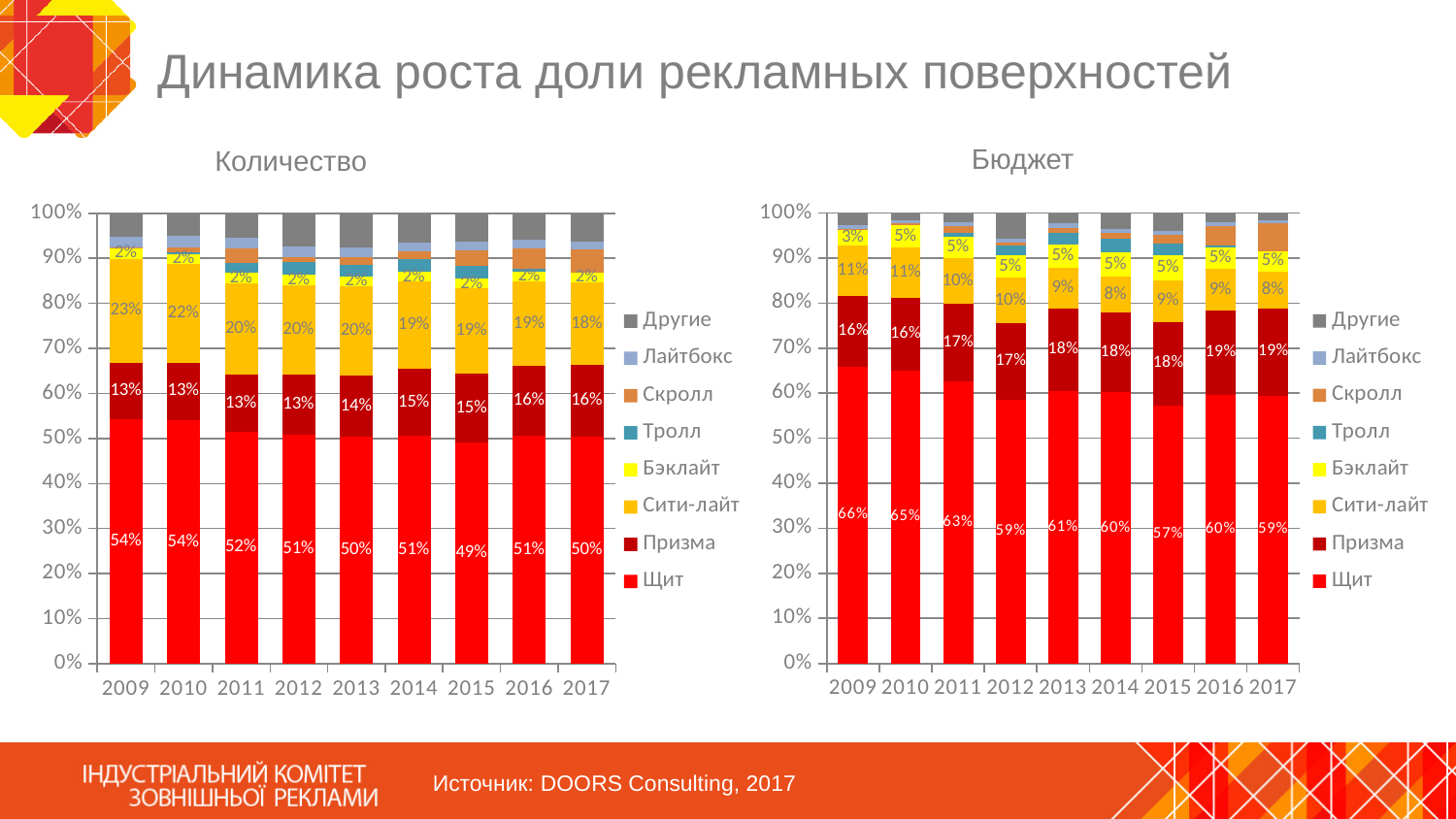
In the Бюджет chart, which is larger: the Щит value for 2012 or for 2013? 2013 How many years are shown on the x axis of the Количество chart? 9 In the Количество chart, what is the difference between the Сити-лайт values for 2009 and 2017? 5% In the Бюджет chart, is the value for Бэклайт in 2009 greater or less than 5%? less What kind of chart is the Количество chart? Stacked bar chart In the Количество chart, does the Призма value rise or fall from 2009 to 2017? rise How many series does the legend of the Бюджет chart list? 8 In the Бюджет chart, what is the value for Призма in 2017? 19% In the Бюджет chart, what is the value for Сити-лайт in 2011? 10% In the Количество chart, what is the value for Щит in 2009? 54% In the Бюджет chart, which year has the highest value for Щит? 2009 In the Количество chart, which year has the lowest value for Щит? 2015